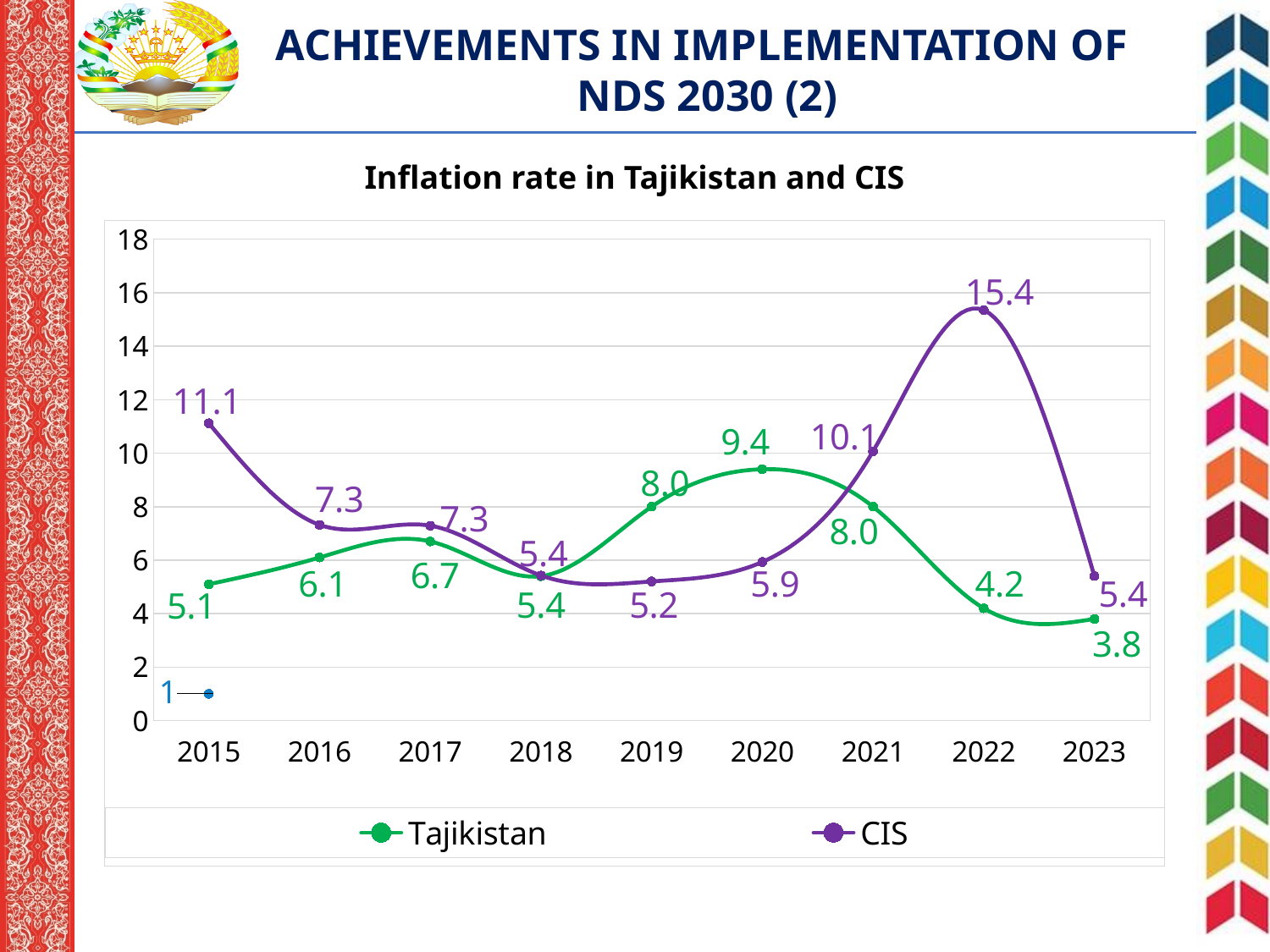
In which year is the Tajikistan inflation rate lowest? 2023 What is the title of the chart? Inflation rate in Tajikistan and CIS What is the inflation rate for CIS in 2015? 11.1 How many series does the legend list? 2 Which had the higher inflation rate in 2019, Tajikistan or CIS? Tajikistan What is the difference between the CIS and Tajikistan inflation rates in 2022? 11.2 What type of chart is shown on the slide? Line chart What is the inflation rate for Tajikistan in 2023? 3.8 In which year is the CIS inflation rate highest? 2022 How many years are shown on the x axis? 9 What is the inflation rate for CIS in 2022? 15.4 What is the inflation rate for Tajikistan in 2020? 9.4